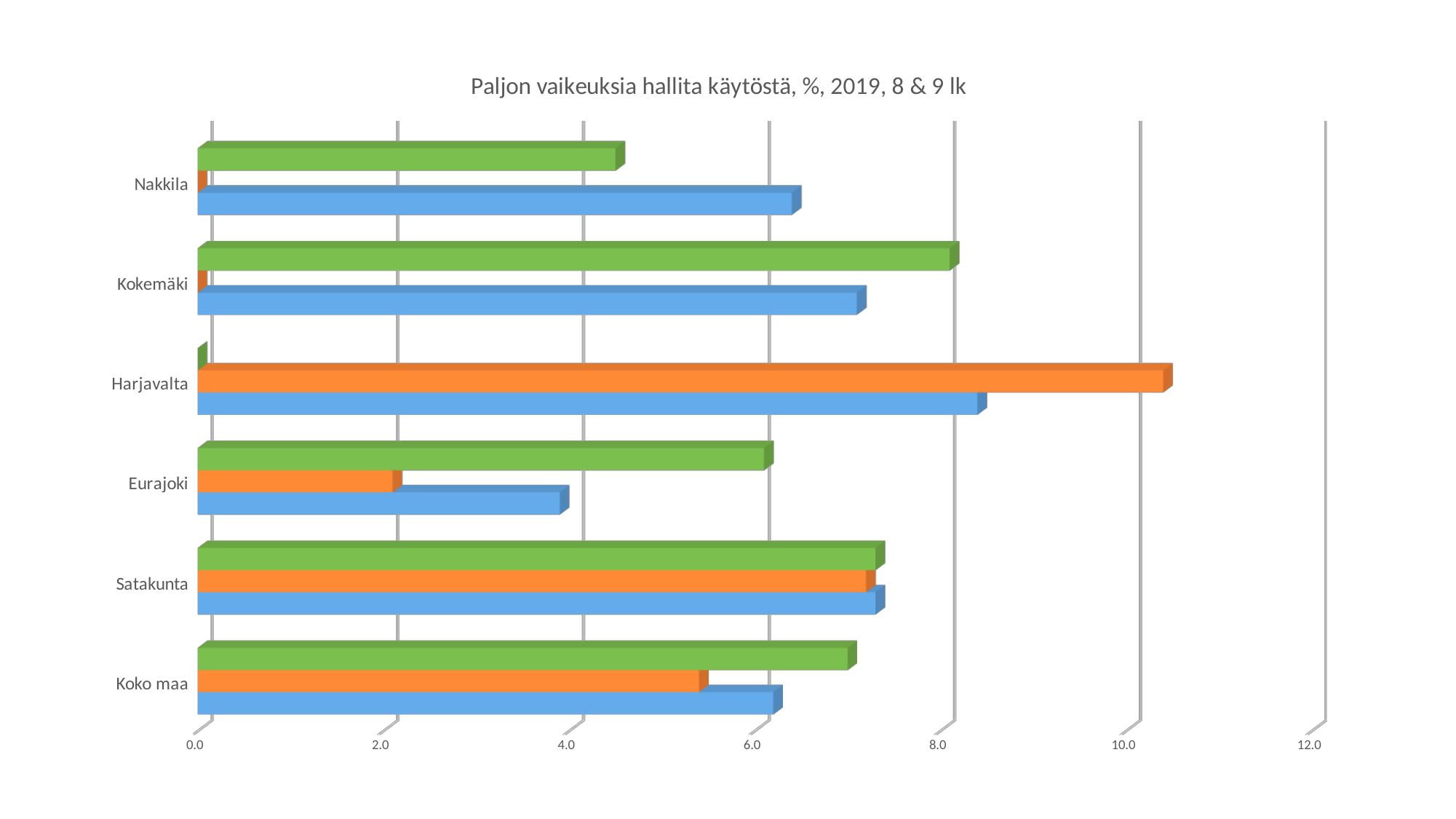
Which category has the longest blue bar? Harjavalta Which category has the longest orange bar? Harjavalta How many bars (series) are plotted for each category? 3 Is the blue bar for Nakkila greater or less than 6.0? greater What is the title of the chart? Paljon vaikeuksia hallita käytöstä, %, 2019, 8 & 9 lk Which category has the shortest green bar? Harjavalta For Eurajoki, which is larger: the green bar or the blue bar? the green bar What kind of chart is shown on the slide? bar chart Is the orange bar for Koko maa greater or less than 6.0? less For Nakkila, which is larger: the blue bar or the green bar? the blue bar Is the orange bar for Harjavalta greater or less than 10.0? greater How many categories are shown on the vertical axis of the chart? 6